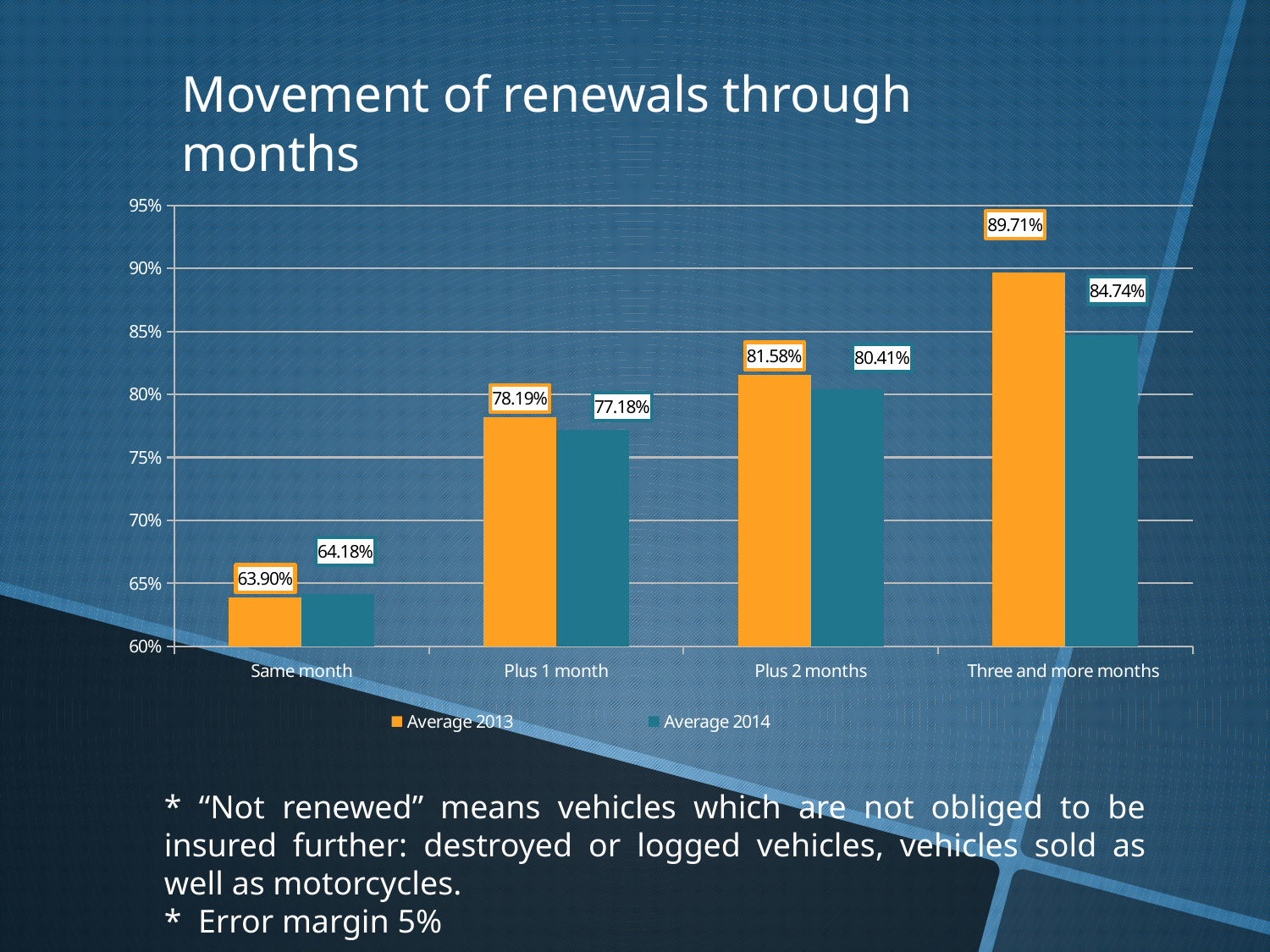
What is the Average 2014 value for Three and more months? 84.74% Do the Average 2014 values rise or fall from Same month to Three and more months? Rise How many series does the legend list? 2 Which is larger for Plus 2 months, Average 2013 or Average 2014? Average 2013 Which category has the lowest Average 2014 value? Same month What is the difference between the Average 2013 and Average 2014 values for Three and more months? 4.97 percentage points Which category has the highest Average 2013 value? Three and more months What kind of chart is shown on the slide? Bar chart What is the Average 2014 value for Same month? 64.18% Is the Average 2013 value for Plus 2 months greater or less than 80%? greater How many categories are shown on the x axis? 4 What is the Average 2013 value for Plus 1 month? 78.19%